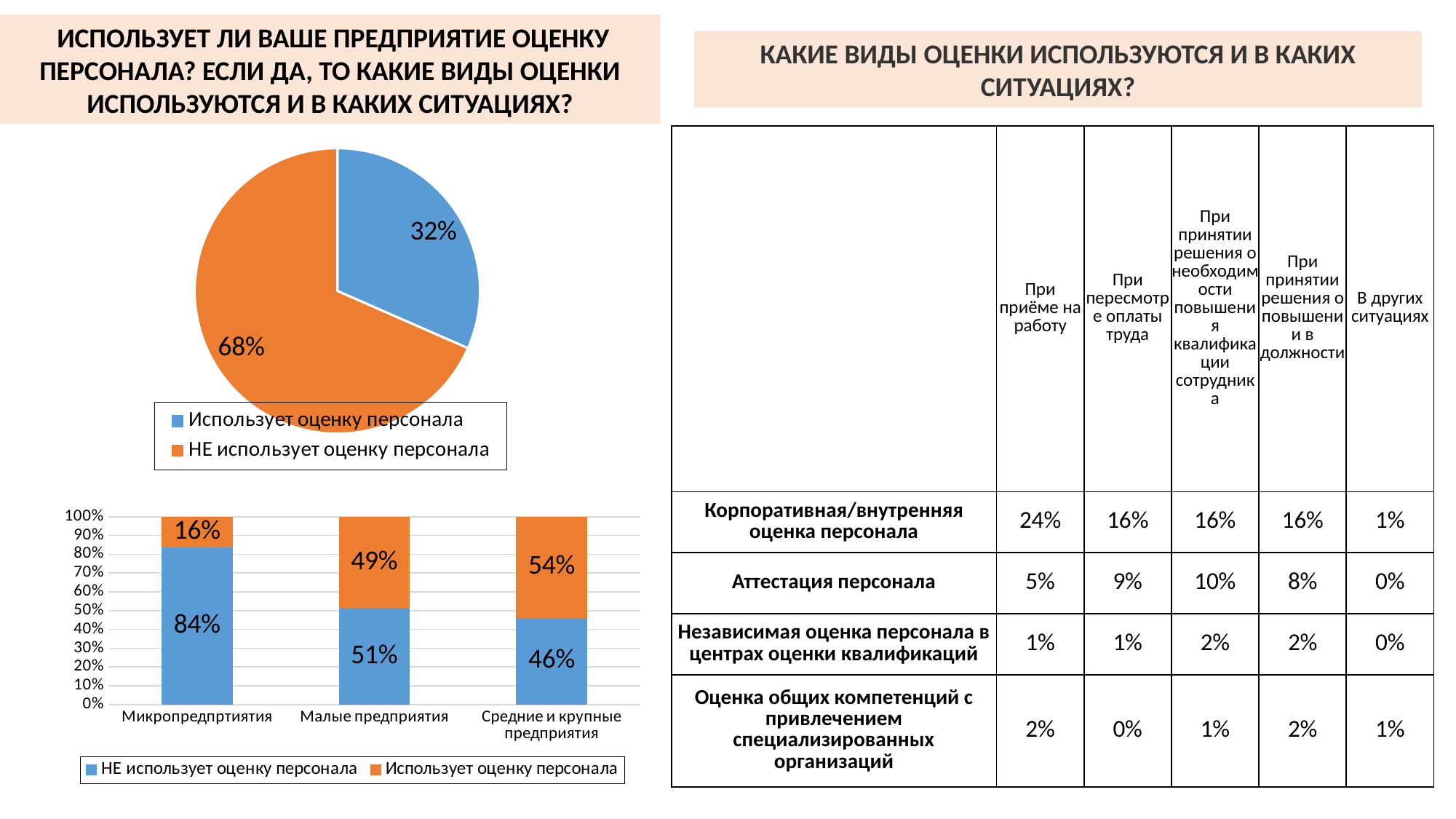
How many series does the legend of the stacked bar chart list? 2 In the stacked bar chart, which category has the lowest value for the orange segment? Микропредпртития In the pie chart, what share is labelled for 'НЕ использует оценку персонала'? 68% In the stacked bar chart, which category has the highest value for the blue segment? Микропредпртития In the pie chart, which slice is larger: 'Использует оценку персонала' or 'НЕ использует оценку персонала'? НЕ использует оценку персонала What type of chart is the lower chart on the left side of the slide? Bar chart In the stacked bar chart, what is the value of the blue segment for 'Микропредпртития'? 84% How many slices does the pie chart have? 2 In the pie chart, what share is labelled for the blue slice 'Использует оценку персонала'? 32% In the stacked bar chart, what is the value of the orange segment for 'Средние и крупные предприятия'? 54% In the stacked bar chart, what is the difference between the blue segment values for 'Микропредпртития' and 'Малые предприятия'? 33% In the stacked bar chart, what is the value of the orange segment for 'Малые предприятия'? 49%